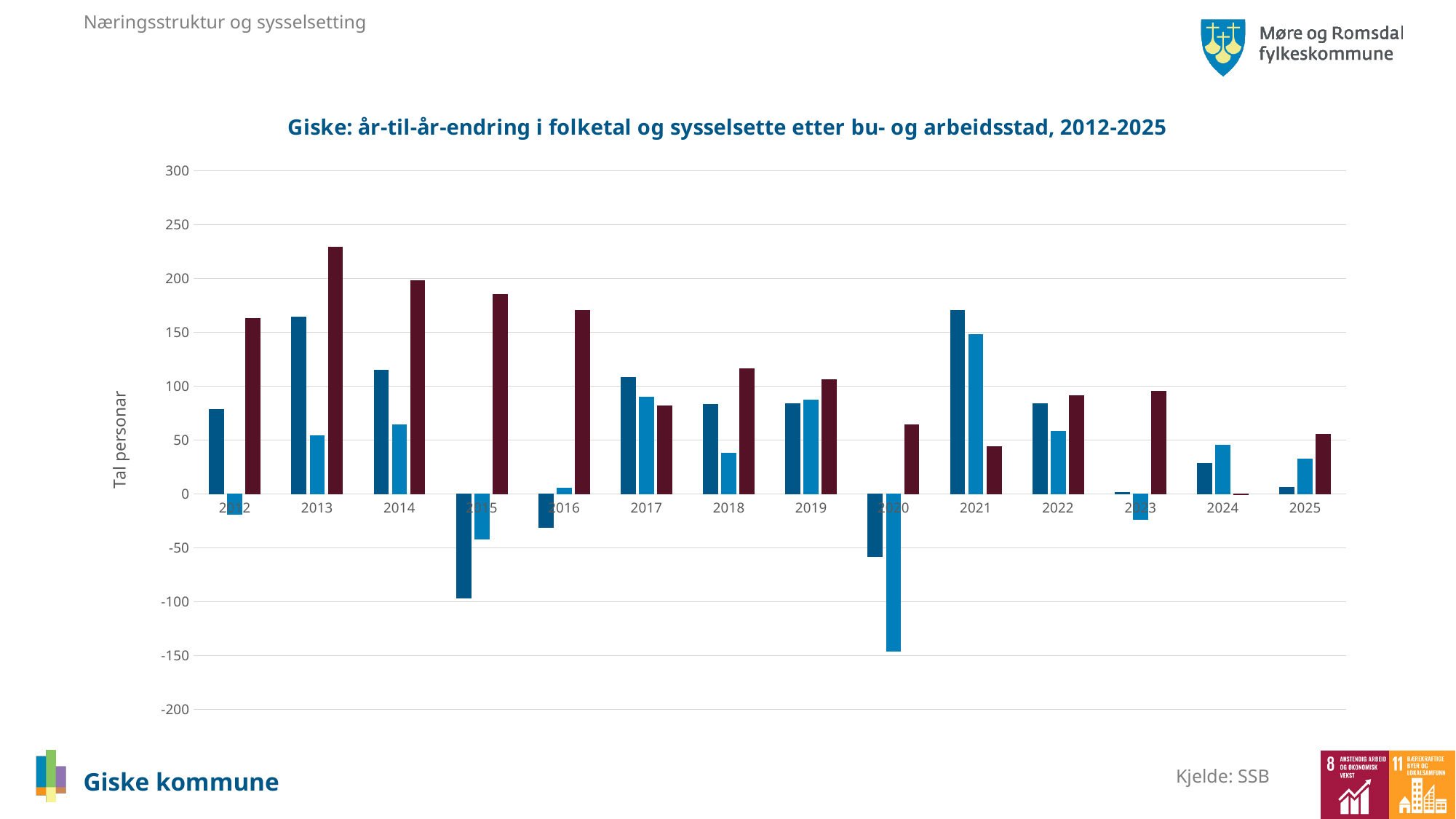
In 2021, which is larger: the dark blue bar or the dark red bar? the dark blue bar Is the value of the light blue bar for 2020 greater or less than -100? less In which year is the dark red bar the tallest? 2013 Is the value of the dark blue bar for 2015 greater or less than -50? less Is the value of the dark blue bar for 2021 greater or less than 150? greater What is the label on the vertical axis of the chart? Tal personar What kind of chart is shown on the slide? bar chart In which year is the light blue bar the tallest? 2021 What is the title of the chart? Giske: år-til-år-endring i folketal og sysselsette etter bu- og arbeidsstad, 2012-2025 In which year is the light blue bar the lowest? 2020 How many years are shown along the x axis of the chart? 14